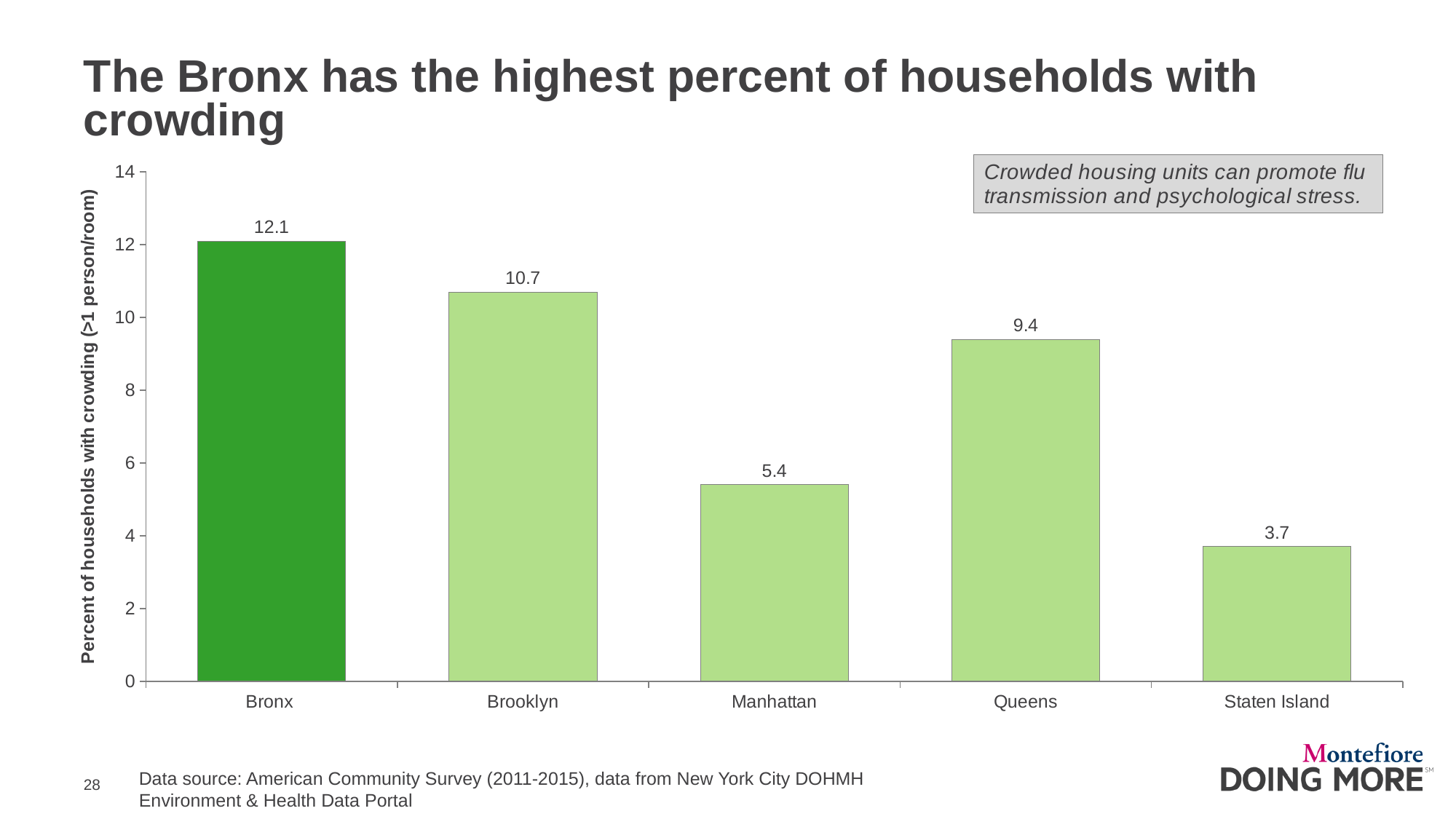
Which has a higher percent of households with crowding, Brooklyn or Queens? Brooklyn How many boroughs are shown on the chart? 5 Which borough has the lowest percent of households with crowding? Staten Island What is the percent of households with crowding in Manhattan? 5.4 What is the value shown for Queens? 9.4 What is the percent of households with crowding in the Bronx? 12.1 Which borough has the highest percent of households with crowding? Bronx What kind of chart is shown on the slide? bar chart What is the difference between the values for Queens and Staten Island? 5.7 What is the difference between the values for the Bronx and Brooklyn? 1.4 Which bar is shown in a darker shade of green than the others? Bronx Is the value for Manhattan greater or less than 6? less